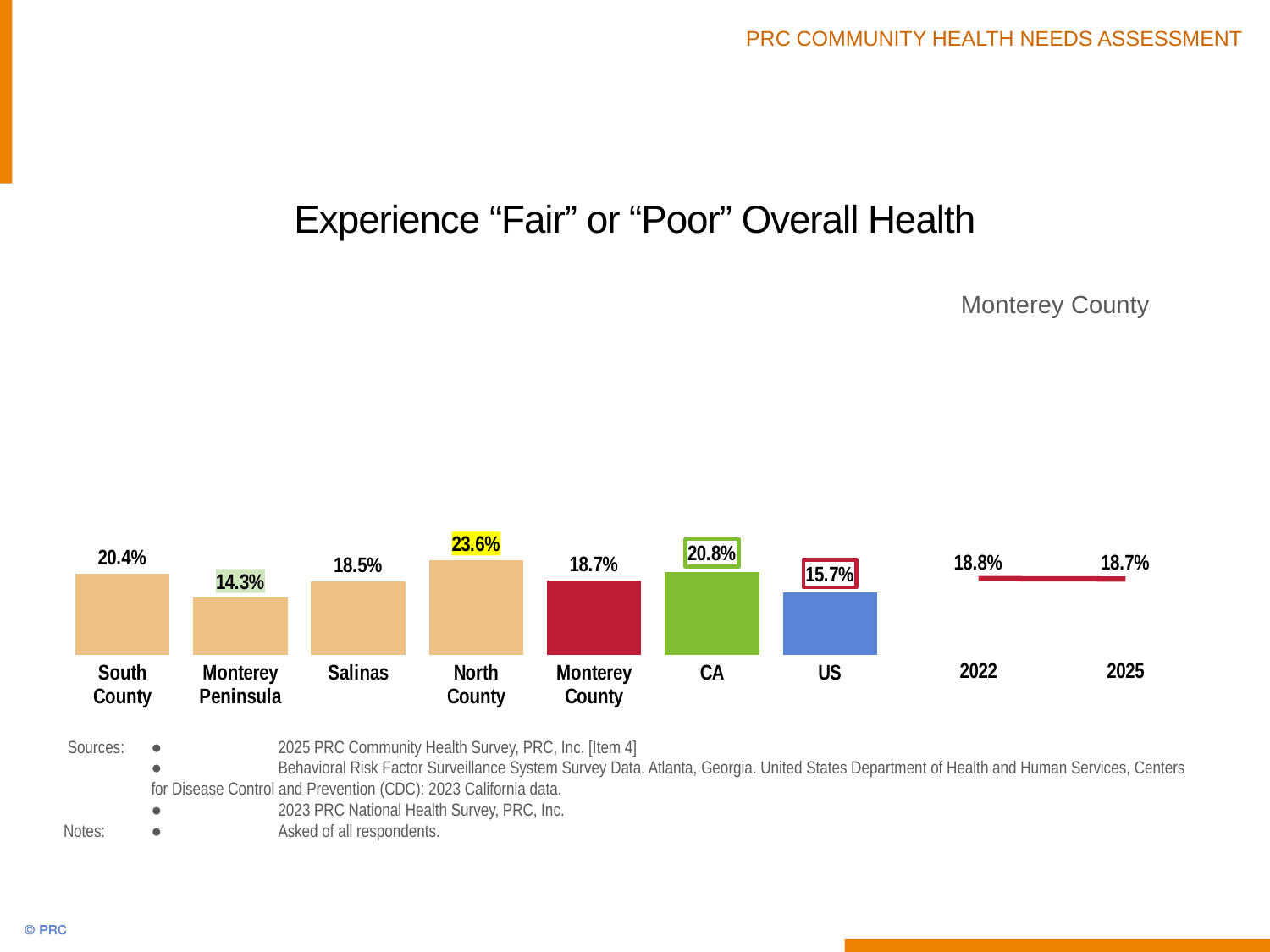
In the bar chart, what is the difference between the values for North County and Monterey County? 4.9% In the line chart on the right, what is the value for 2022? 18.8% In the bar chart, what is the value for North County? 23.6% In the bar chart, what is the value for the US? 15.7% In the bar chart, which category has the lowest value? Monterey Peninsula In the line chart on the right, does the value rise or fall from 2022 to 2025? Fall In the bar chart, what is the value for Monterey Peninsula? 14.3% How many bars are shown in the bar chart? 7 What kind of chart is the chart on the left of the slide? Bar chart In the bar chart, which category has the highest value? North County In the bar chart, which is larger, the value for CA or the value for the US? CA What is the title of the chart on the slide? Experience "Fair" or "Poor" Overall Health